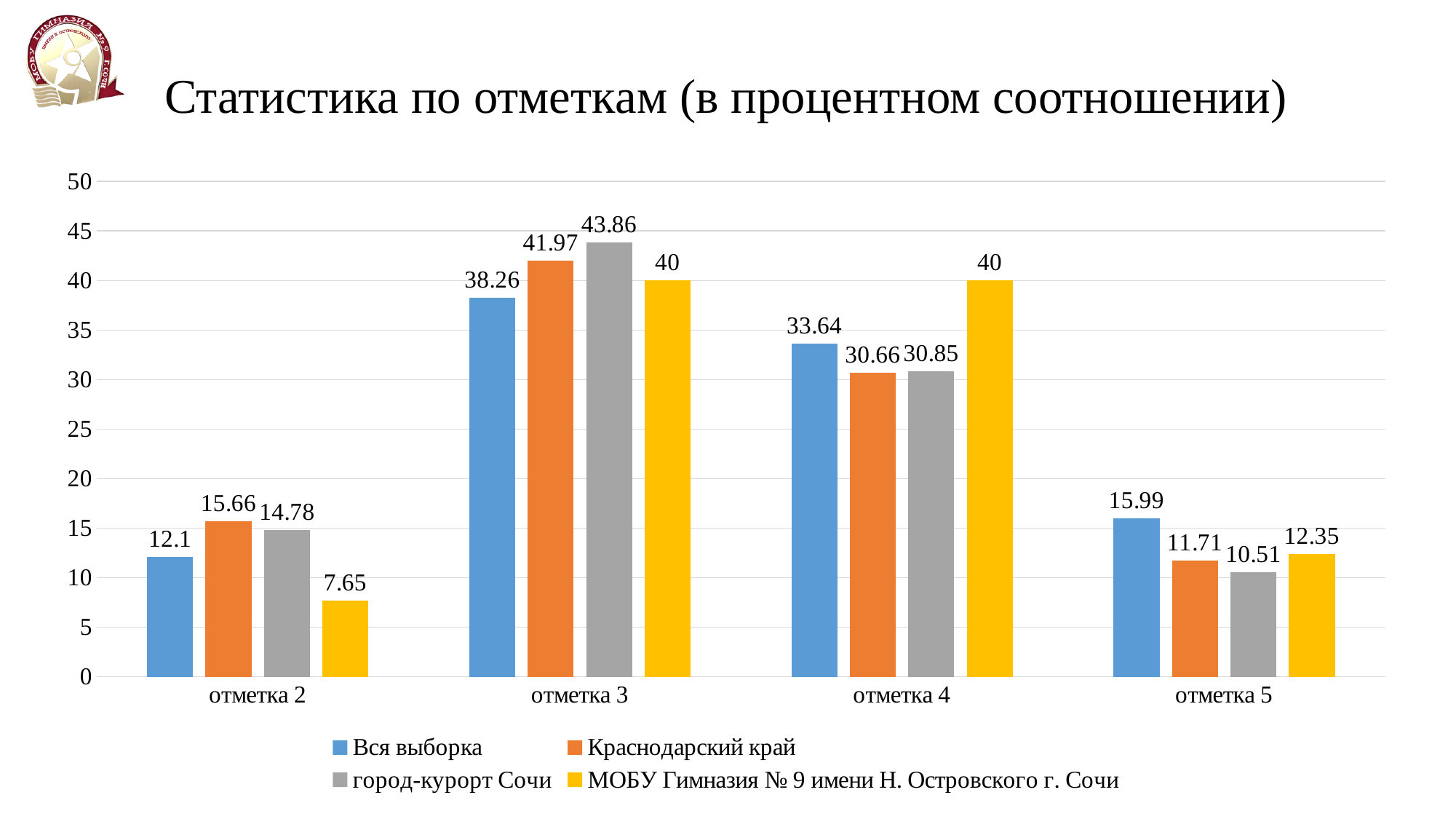
What is the difference between the Краснодарский край and Вся выборка values at отметка 4? 2.98 How many categories are shown on the x axis? 4 What is the value for город-курорт Сочи at отметка 5? 10.51 Which series has the highest value at отметка 3? город-курорт Сочи How many series does the legend list? 4 Which series has the lowest value at отметка 2? МОБУ Гимназия № 9 имени Н. Островского г. Сочи What is the value for Вся выборка at отметка 3? 38.26 Which is larger at отметка 5: Вся выборка or Краснодарский край? Вся выборка Is the value for Вся выборка at отметка 4 greater or less than 30? greater What is the value for МОБУ Гимназия № 9 имени Н. Островского г. Сочи at отметка 2? 7.65 What kind of chart is shown on the slide? bar chart What is the title of the chart? Статистика по отметкам (в процентном соотношении)